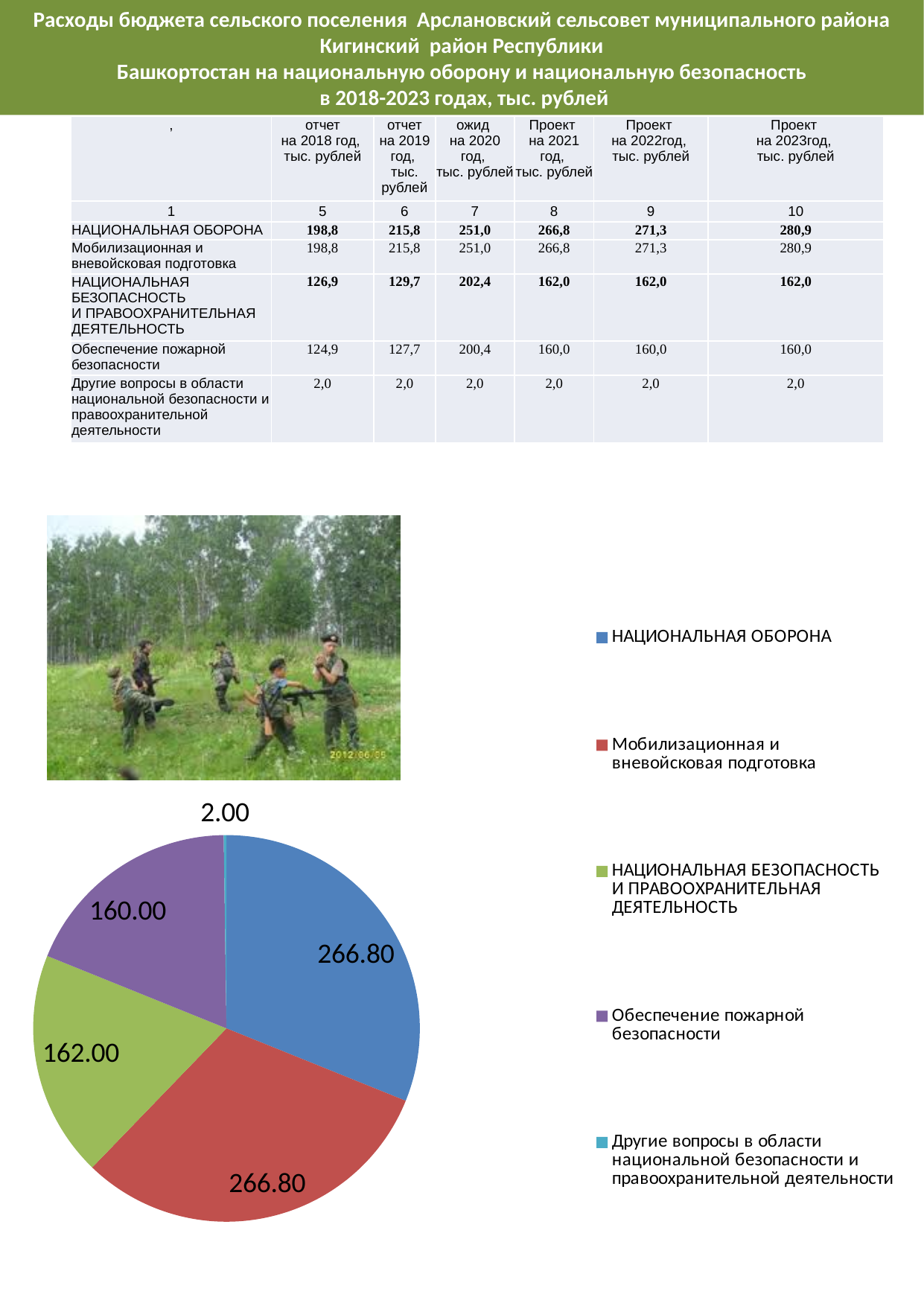
In the pie chart, which is larger: the Мобилизационная и вневойсковая подготовка slice or the Обеспечение пожарной безопасности slice? Мобилизационная и вневойсковая подготовка How many slices does the pie chart have? 5 What is the value of the Другие вопросы в области национальной безопасности и правоохранительной деятельности slice in the pie chart? 2.00 What is the difference between the НАЦИОНАЛЬНАЯ БЕЗОПАСНОСТЬ И ПРАВООХРАНИТЕЛЬНАЯ ДЕЯТЕЛЬНОСТЬ slice and the Обеспечение пожарной безопасности slice in the pie chart? 2.00 What is the difference between the НАЦИОНАЛЬНАЯ ОБОРОНА slice and the НАЦИОНАЛЬНАЯ БЕЗОПАСНОСТЬ И ПРАВООХРАНИТЕЛЬНАЯ ДЕЯТЕЛЬНОСТЬ slice in the pie chart? 104.80 Which category has the smallest slice in the pie chart? Другие вопросы в области национальной безопасности и правоохранительной деятельности What type of chart is shown on the slide? pie chart What is the value of the Обеспечение пожарной безопасности slice in the pie chart? 160.00 What colour is the НАЦИОНАЛЬНАЯ ОБОРОНА slice in the pie chart? blue What is the value of the НАЦИОНАЛЬНАЯ ОБОРОНА slice in the pie chart? 266.80 What is the value of the НАЦИОНАЛЬНАЯ БЕЗОПАСНОСТЬ И ПРАВООХРАНИТЕЛЬНАЯ ДЕЯТЕЛЬНОСТЬ slice in the pie chart? 162.00 How many entries does the pie chart legend list? 5